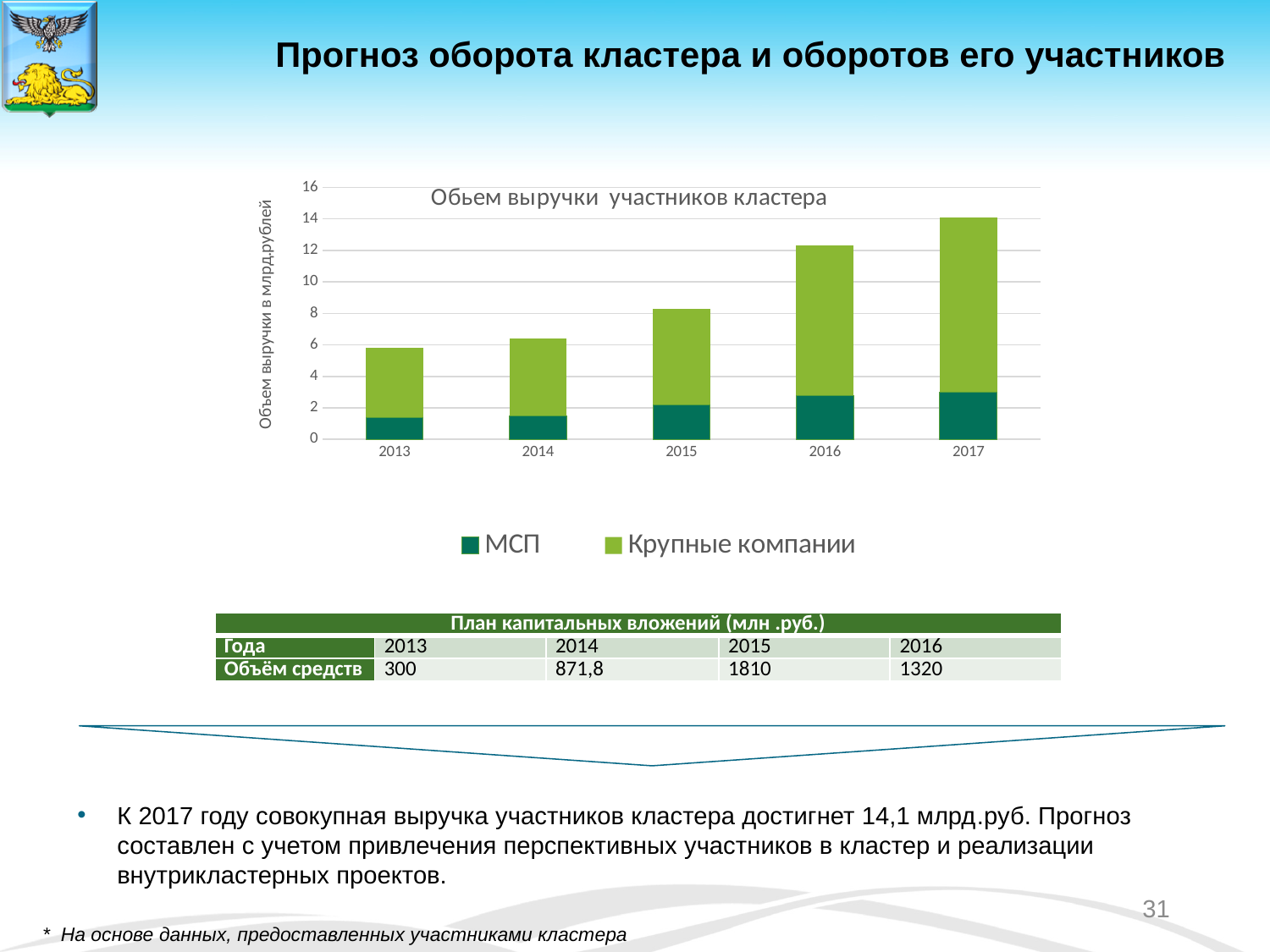
Is the МСП segment for 2013 greater or less than 2? less Which two series are listed in the chart legend? МСП and Крупные компании Is the total bar for 2017 greater or less than 12? greater Which year has the lowest total bar in the chart? 2013 Which year has the highest total bar in the chart? 2017 Do the total bar heights rise or fall from 2013 to 2017? Rise What kind of chart is shown on the slide? Stacked bar chart Is the total bar for 2013 greater or less than 8? less What is the title of the chart? Обьем выручки участников кластера How many years are shown on the x axis of the chart? 5 Which year has the larger total bar, 2015 or 2016? 2016 How many series does the chart legend list? 2